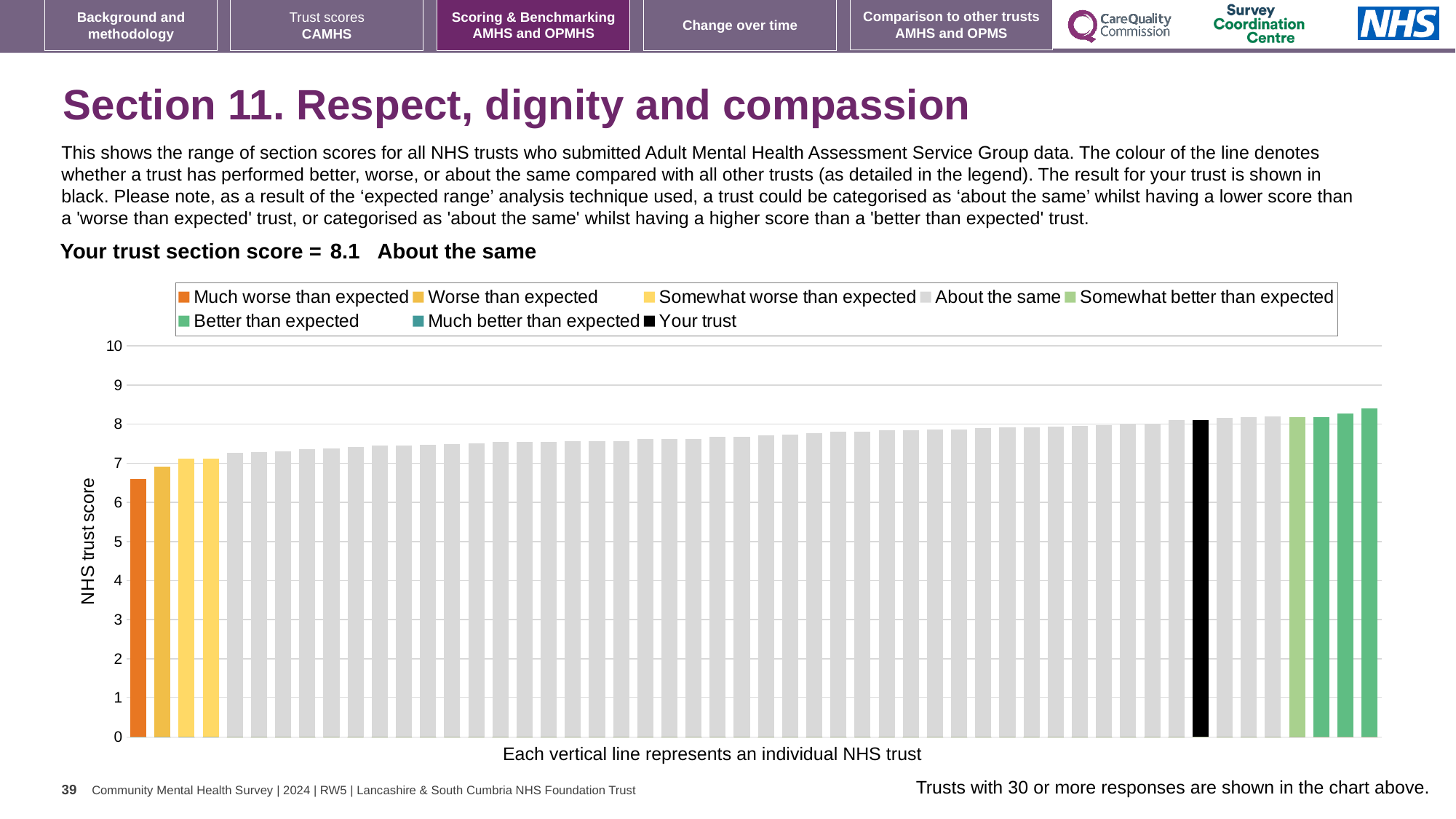
Is the value of the lowest (orange) bar greater or less than 7? less What is the section score for your trust shown on the slide? 8.1 What kind of chart is shown on the slide? bar chart Is the value of the tallest bar greater or less than 8? greater What is the label on the vertical axis of the chart? NHS trust score How many bars in the chart are coloured orange (Much worse than expected)? 1 What colour is the bar representing your trust? black How many entries does the chart legend list? 8 Which performance category is your trust placed in for this section? About the same Is the tallest bar in the chart higher or lower than the black 'Your trust' bar? higher Which legend category does the tallest bar in the chart belong to? Better than expected Which legend category does the lowest bar in the chart belong to? Much worse than expected